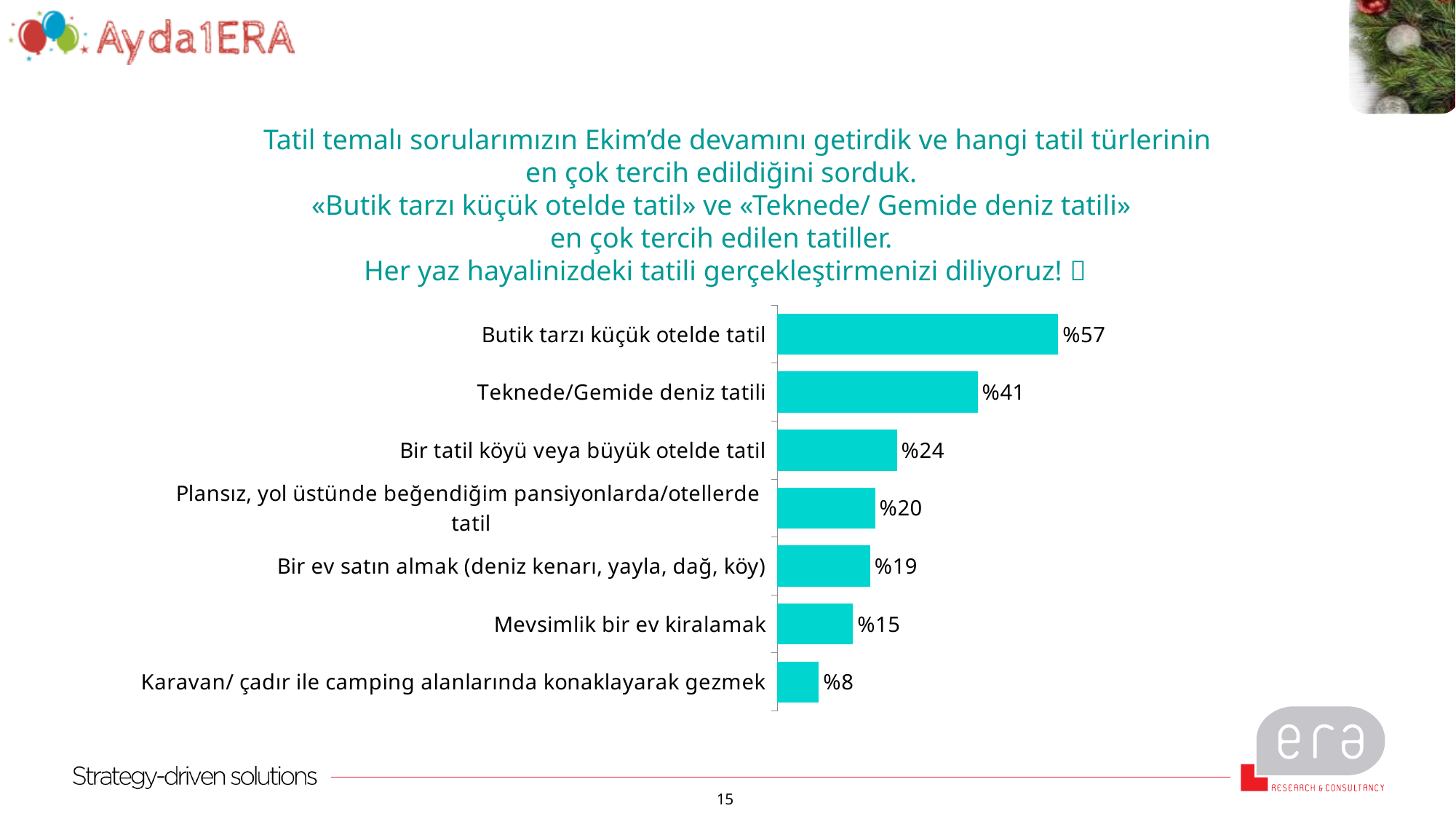
What kind of chart is shown on the slide? Bar chart What colour are the bars in the chart? Turquoise What is the value for "Mevsimlik bir ev kiralamak"? %15 What is the value for "Teknede/Gemide deniz tatili"? %41 How many categories are shown in the chart? 7 What is the value for "Karavan/ çadır ile camping alanlarında konaklayarak gezmek"? %8 Which category has the highest value? Butik tarzı küçük otelde tatil What is the value for "Butik tarzı küçük otelde tatil"? %57 What is the difference between the values for "Butik tarzı küçük otelde tatil" and "Teknede/Gemide deniz tatili"? %16 Which is larger: the value for "Bir tatil köyü veya büyük otelde tatil" or for "Bir ev satın almak (deniz kenarı, yayla, dağ, köy)"? Bir tatil köyü veya büyük otelde tatil What is the difference between the values for "Bir tatil köyü veya büyük otelde tatil" and "Mevsimlik bir ev kiralamak"? %9 Which category has the lowest value? Karavan/ çadır ile camping alanlarında konaklayarak gezmek